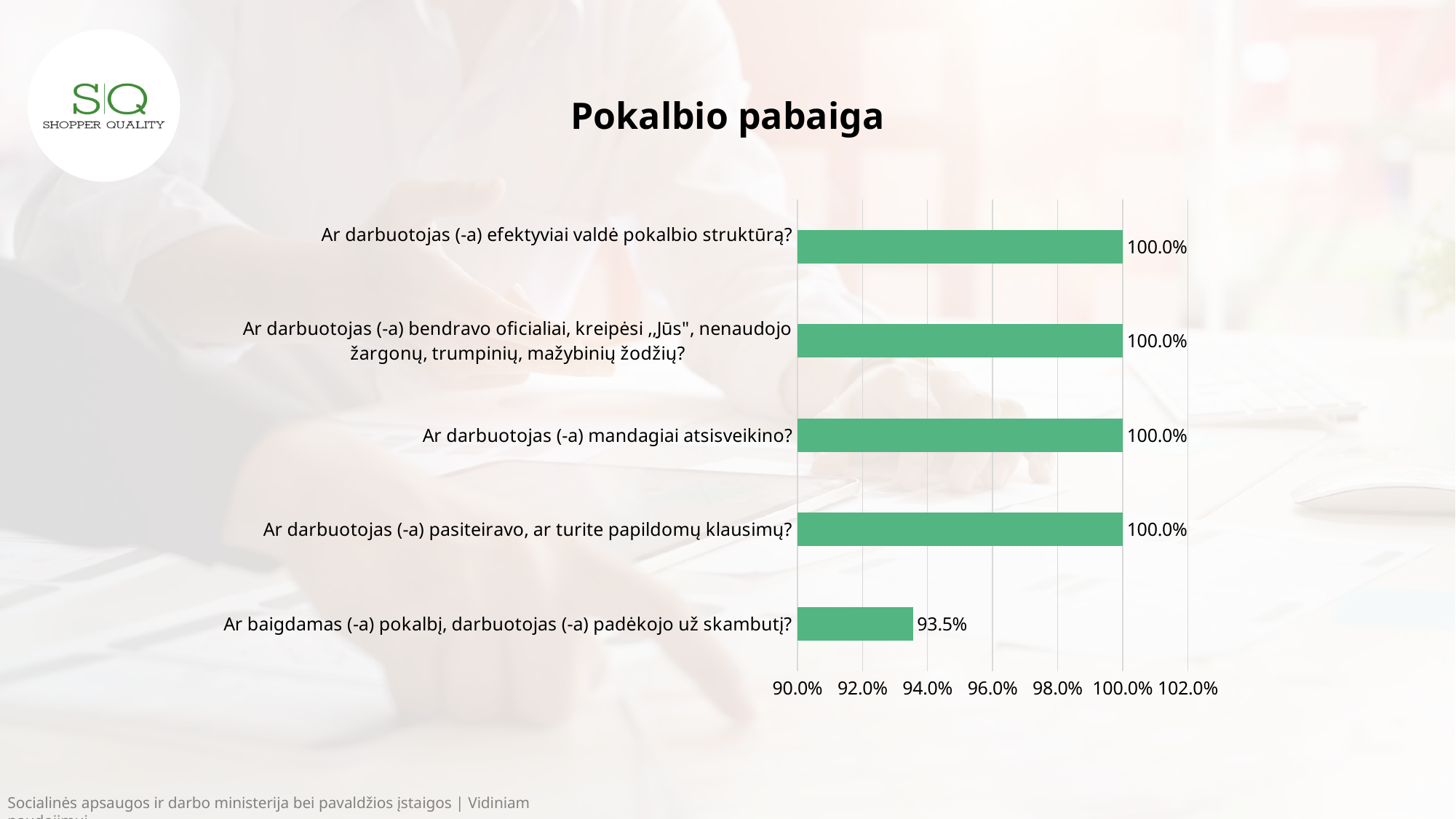
What is the value for "Ar darbuotojas (-a) mandagiai atsisveikino?"? 100.0% What is the title of the chart? Pokalbio pabaiga What is the difference between the value for "Ar darbuotojas (-a) efektyviai valdė pokalbio struktūrą?" and the value for "Ar baigdamas (-a) pokalbį, darbuotojas (-a) padėkojo už skambutį?"? 6.5% What is the value for "Ar darbuotojas (-a) pasiteiravo, ar turite papildomų klausimų?"? 100.0% Is the value for "Ar baigdamas (-a) pokalbį, darbuotojas (-a) padėkojo už skambutį?" greater or less than 96.0%? less How many categories have a value of 100.0%? 4 What kind of chart is shown on the slide? bar chart How many categories are shown in the chart? 5 What is the value for "Ar baigdamas (-a) pokalbį, darbuotojas (-a) padėkojo už skambutį?"? 93.5% What colour are the bars in the chart? green Which is larger: the value for "Ar darbuotojas (-a) mandagiai atsisveikino?" or the value for "Ar baigdamas (-a) pokalbį, darbuotojas (-a) padėkojo už skambutį?"? Ar darbuotojas (-a) mandagiai atsisveikino? Which category has the lowest value? Ar baigdamas (-a) pokalbį, darbuotojas (-a) padėkojo už skambutį?